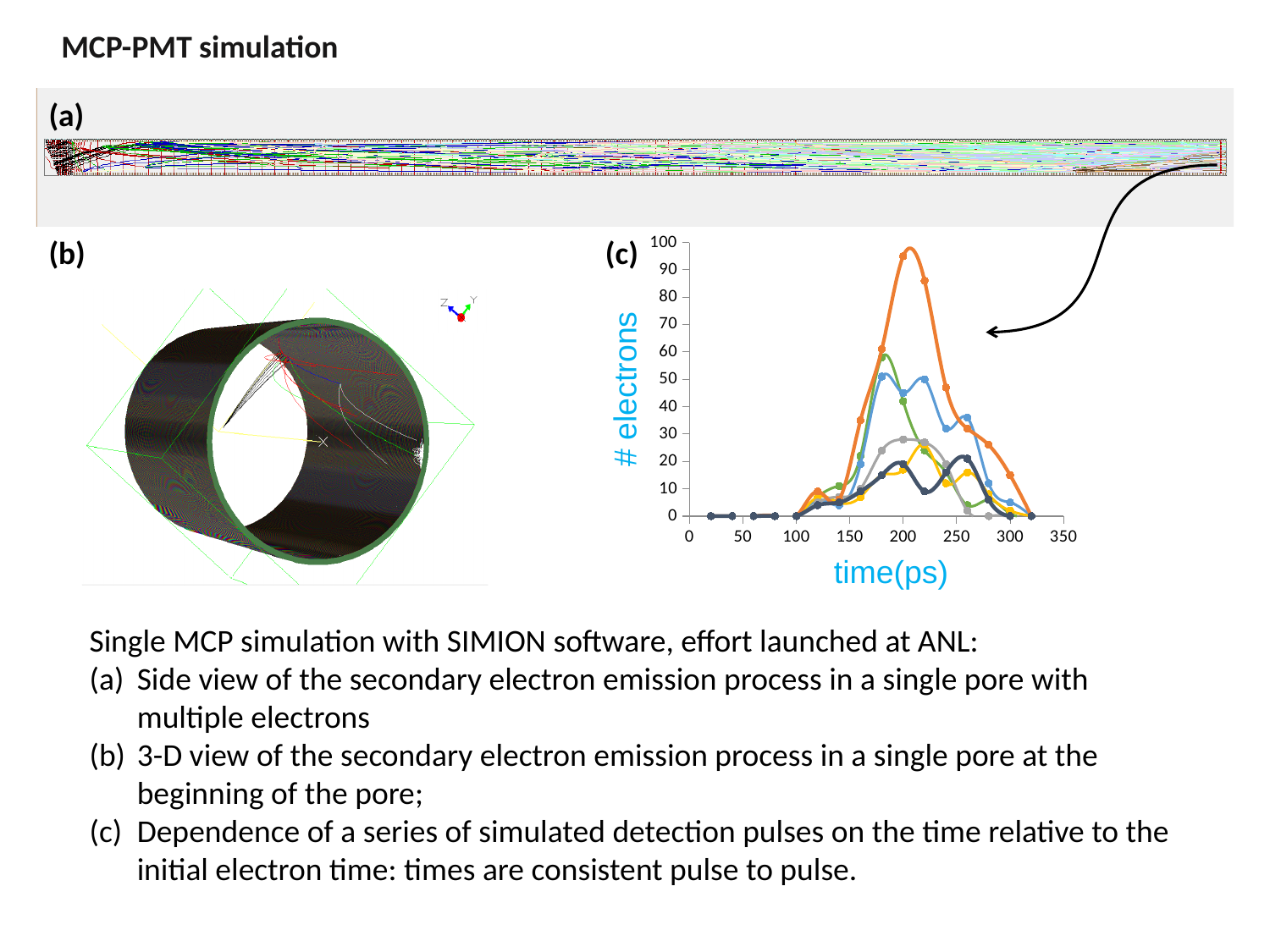
In chart (c), do the values of the orange line rise or fall between 250 ps and 300 ps? fall What kind of chart is chart (c)? line chart In chart (c), is the peak value of the dark navy line greater or less than 30? less In chart (c), what is the label of the y axis? # electrons In chart (c), which coloured line reaches the highest peak? orange In chart (c), is the peak value of the green line greater or less than 50? greater In chart (c), is the peak value of the gray line greater or less than 40? less In chart (c), which line has a higher peak, the orange line or the blue line? orange In chart (c), what is the number of electrons for all lines at 100 ps? 0 In chart (c), do the values of the orange line rise or fall between 150 ps and 200 ps? rise In chart (c), what is the label of the x axis? time(ps)